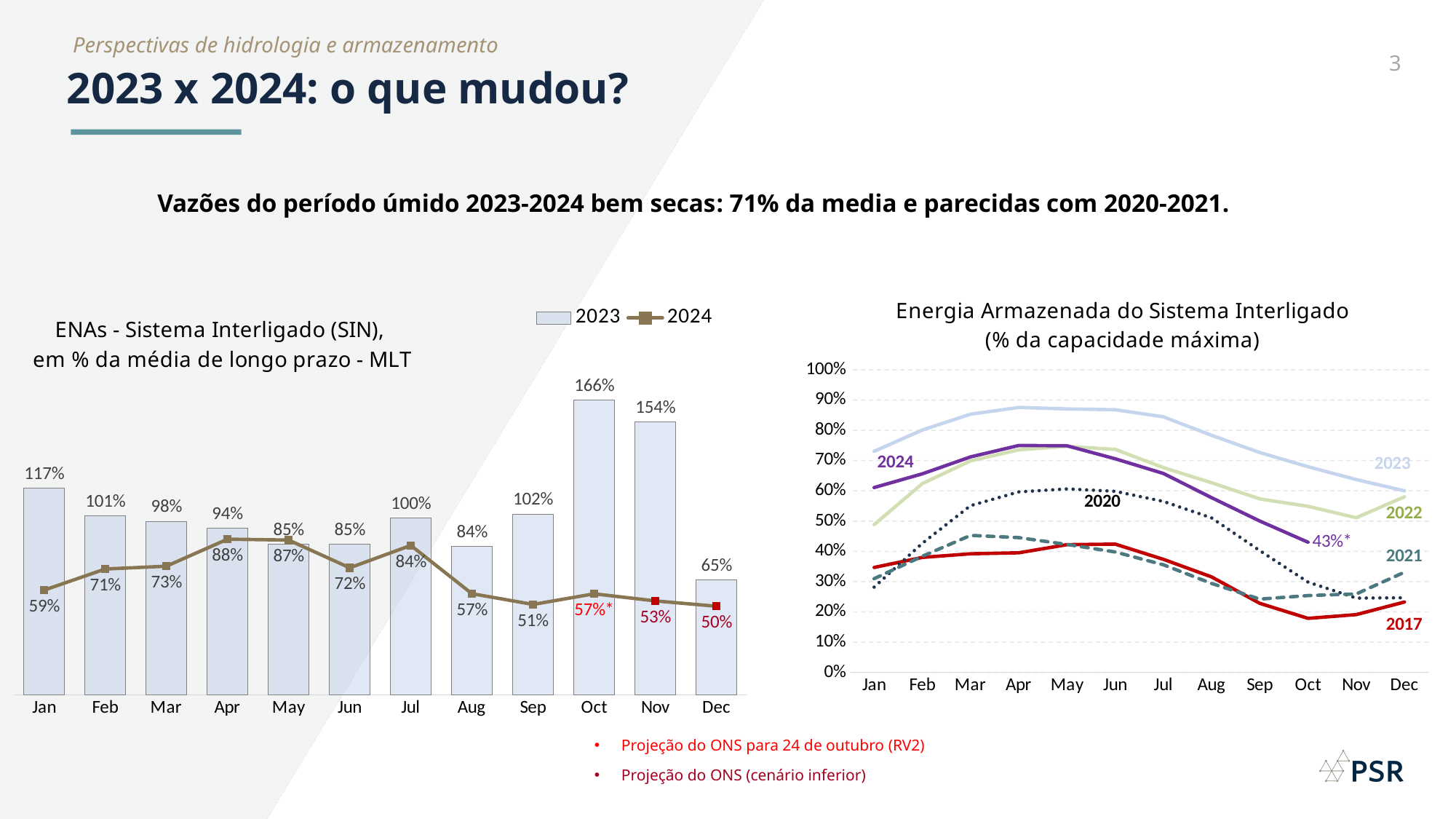
In the ENAs - Sistema Interligado (SIN) chart, what is the 2023 value for Oct? 166% In the Energia Armazenada do Sistema Interligado chart, is the 2017 value for Oct greater or less than 20%? less In the ENAs - Sistema Interligado (SIN) chart, what is the 2024 value for Sep? 51% In the ENAs - Sistema Interligado (SIN) chart, which is larger for Apr: the 2023 value or the 2024 value? 2023 In the ENAs - Sistema Interligado (SIN) chart, what is the difference between the 2023 and 2024 values for Jan? 58% In the Energia Armazenada do Sistema Interligado chart, is the 2023 value for Apr greater or less than 80%? greater In the ENAs - Sistema Interligado (SIN) chart, which month has the highest 2023 value? Oct In the ENAs - Sistema Interligado (SIN) chart, which month has the lowest 2024 value? Dec In the Energia Armazenada do Sistema Interligado chart, what is the labelled 2024 value for Oct? 43%* In the ENAs - Sistema Interligado (SIN) chart, how many series does the legend list? 2 What kind of chart is the Energia Armazenada do Sistema Interligado chart? Line chart In the ENAs - Sistema Interligado (SIN) chart, how many months are shown on the x axis? 12